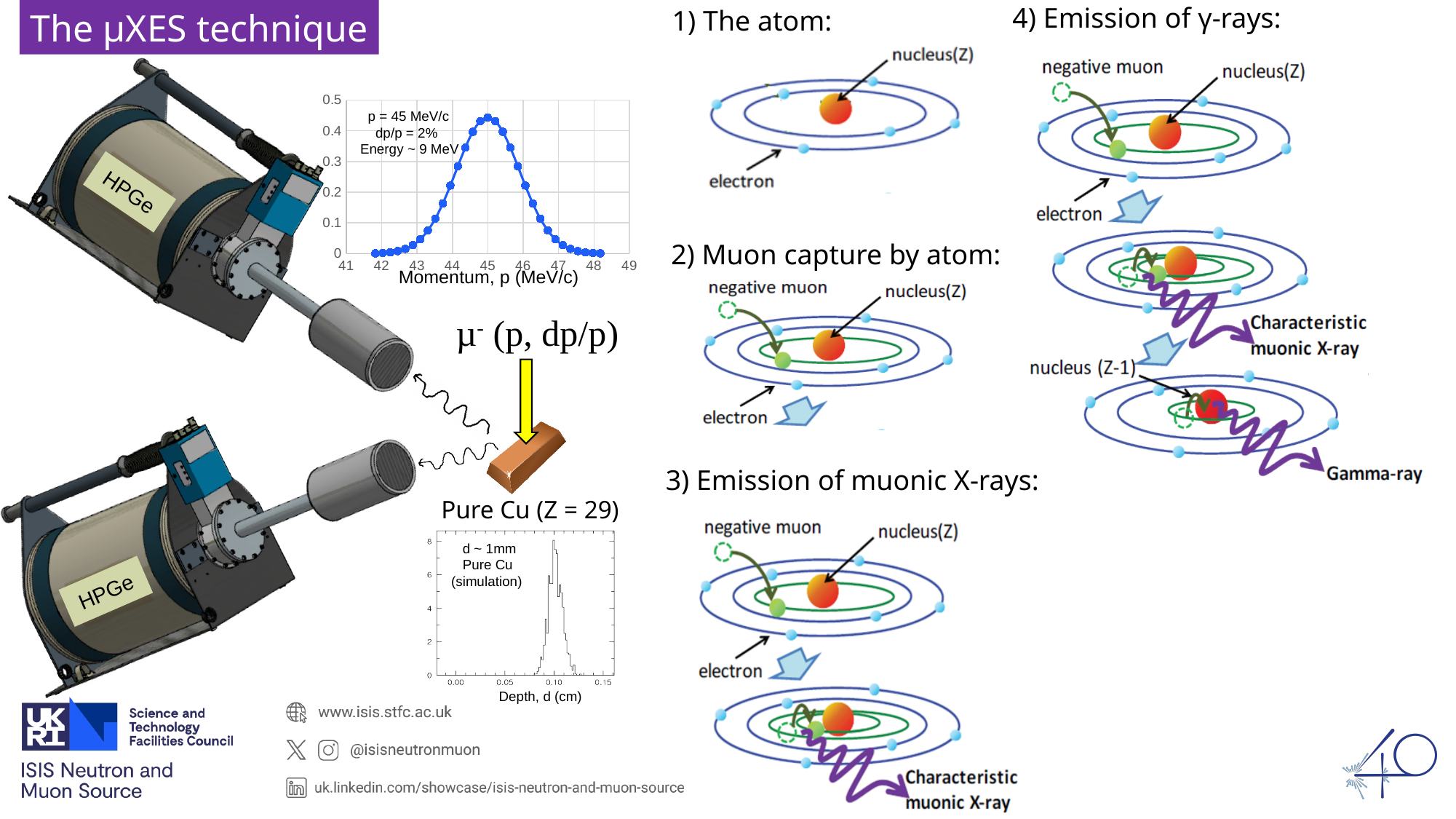
In the momentum chart, at what momentum does the distribution reach its peak? 45 MeV/c In the momentum chart, what momentum spread dp/p is stated in the annotation? 2% In the momentum chart, what is the label of the x axis? Momentum, p (MeV/c) In the momentum chart, do the values rise or fall as momentum increases from 45 to 48 MeV/c? fall In the momentum chart, what kind of chart is used to show the distribution? line chart In the momentum chart, is the value at 43 MeV/c greater or less than 0.1? less In the depth chart, is the peak value greater or less than 6? greater In the momentum chart, is the peak value at 45 MeV/c greater or less than 0.4? greater In the depth chart, what is the label of the x axis? Depth, d (cm)